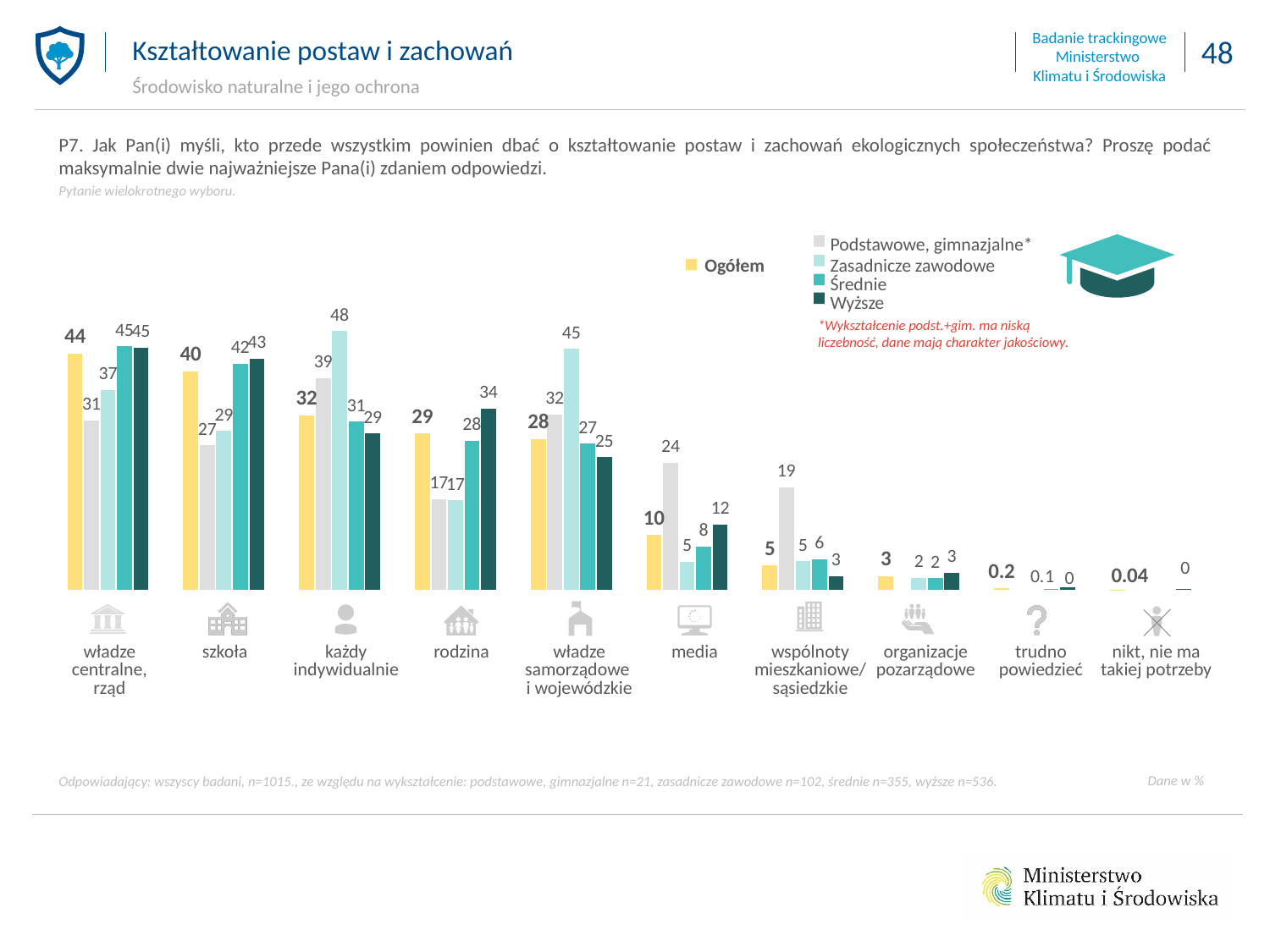
Which category has the highest Ogółem value? władze centralne, rząd How many categories are shown on the x axis of the chart? 10 What is the Ogółem value for 'trudno powiedzieć'? 0.2 What kind of chart is shown on the slide? bar chart How many series does the legend list? 5 What is the Podstawowe, gimnazjalne* value for 'media'? 24 What is the value for 'każdy indywidualnie' in the Zasadnicze zawodowe series? 48 Which category has the lowest Ogółem value? nikt, nie ma takiej potrzeby What is the difference between the Ogółem values for 'szkoła' and 'rodzina'? 11 What is the Wyższe value for 'rodzina'? 34 For 'władze samorządowe i wojewódzkie', which is larger: the Zasadnicze zawodowe value or the Wyższe value? Zasadnicze zawodowe What is the Ogółem value for 'władze centralne, rząd'? 44